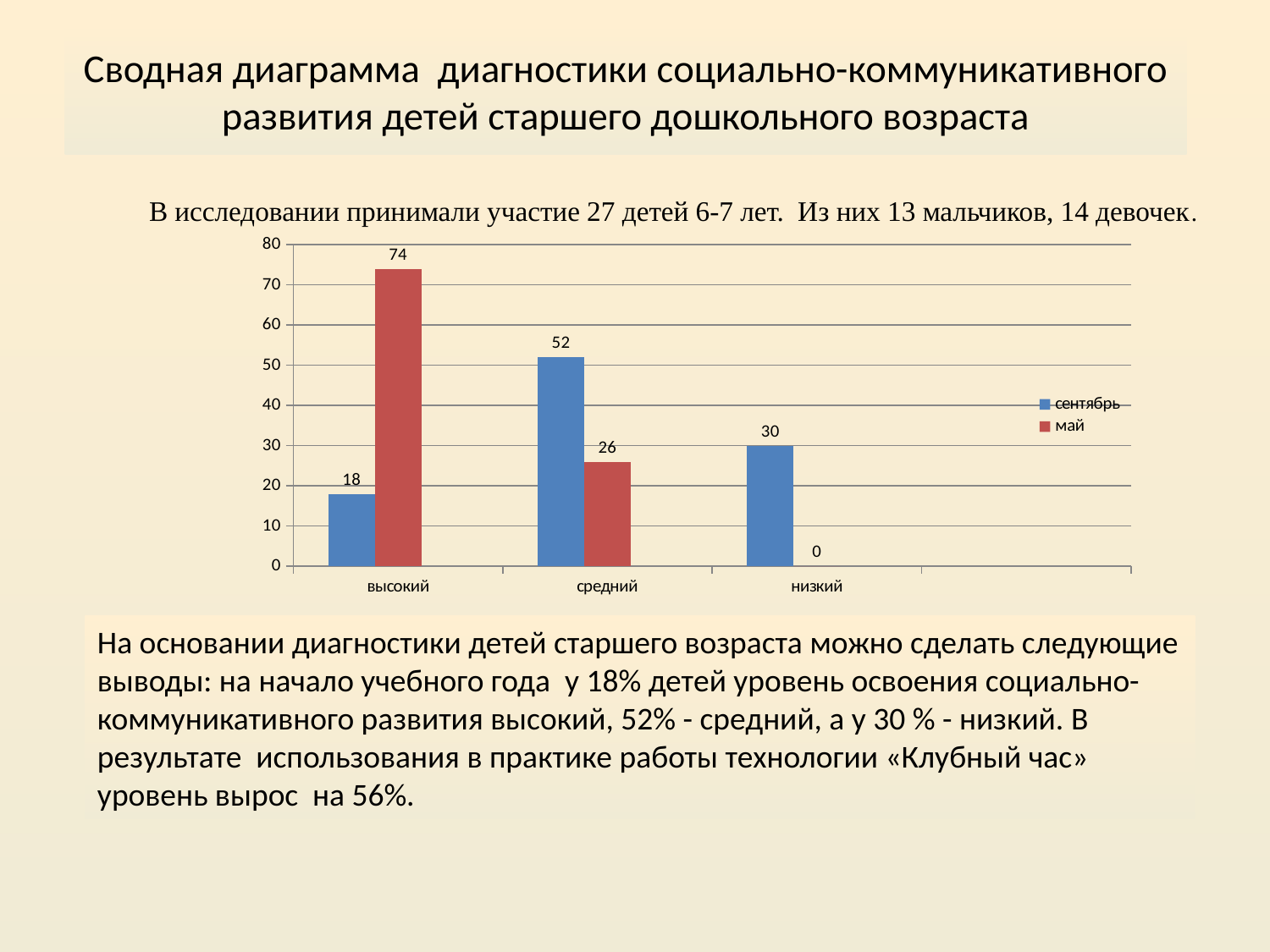
How many series does the legend list? 2 What kind of chart is shown on the slide? bar chart What is the value for май in the низкий category? 0 What is the value for сентябрь in the средний category? 52 What is the value for май in the высокий category? 74 Which category has the highest value for the май series? высокий How many categories are shown on the x axis? 3 Which category has the lowest value for the сентябрь series? высокий In the средний category, which series has the larger value, сентябрь or май? сентябрь Is the value for май in the высокий category greater or less than 70? greater What is the difference between the май and сентябрь values in the высокий category? 56 What is the value for сентябрь in the высокий category? 18